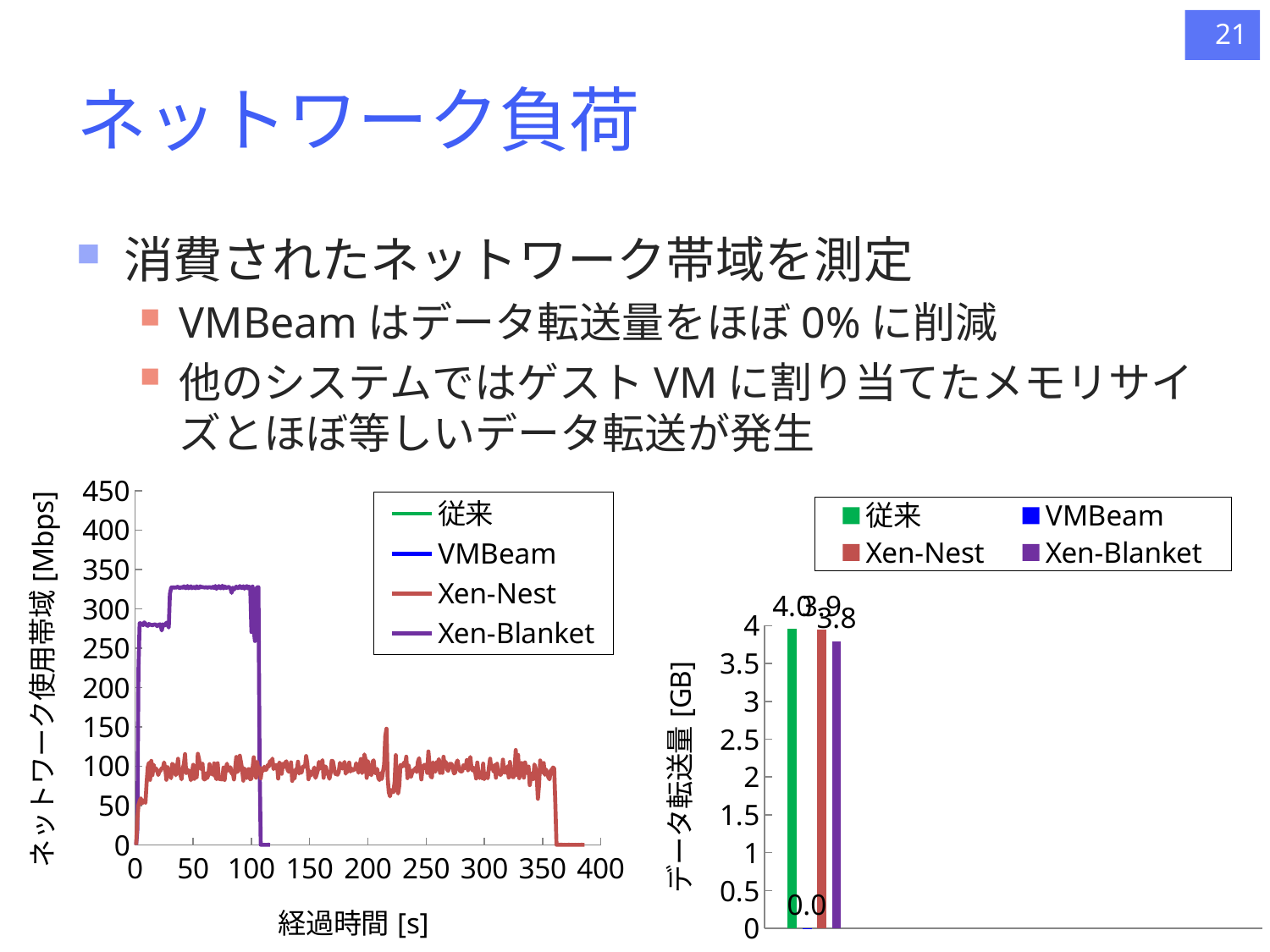
In the bar chart on the right, what is the difference between the data transfer amounts of Xen-Nest and Xen-Blanket? 0.1 In the line chart on the left, is the peak network bandwidth of Xen-Blanket greater or less than 300 Mbps? greater In the line chart on the left, is the network bandwidth of Xen-Nest at 200 s greater or less than 150 Mbps? less What is the x-axis label of the line chart on the left? 経過時間 [s] In the bar chart on the right, what is the data transfer amount for Xen-Blanket? 3.8 What kind of chart is the chart on the right of the slide? bar chart In the bar chart on the right, which system has the lowest data transfer amount? VMBeam In the bar chart on the right, which system has the highest data transfer amount? 従来 In the bar chart on the right, what is the data transfer amount for VMBeam? 0.0 How many series does the legend of the bar chart on the right list? 4 In the bar chart on the right, what is the data transfer amount for Xen-Nest? 3.9 What kind of chart is the chart on the left of the slide? line chart